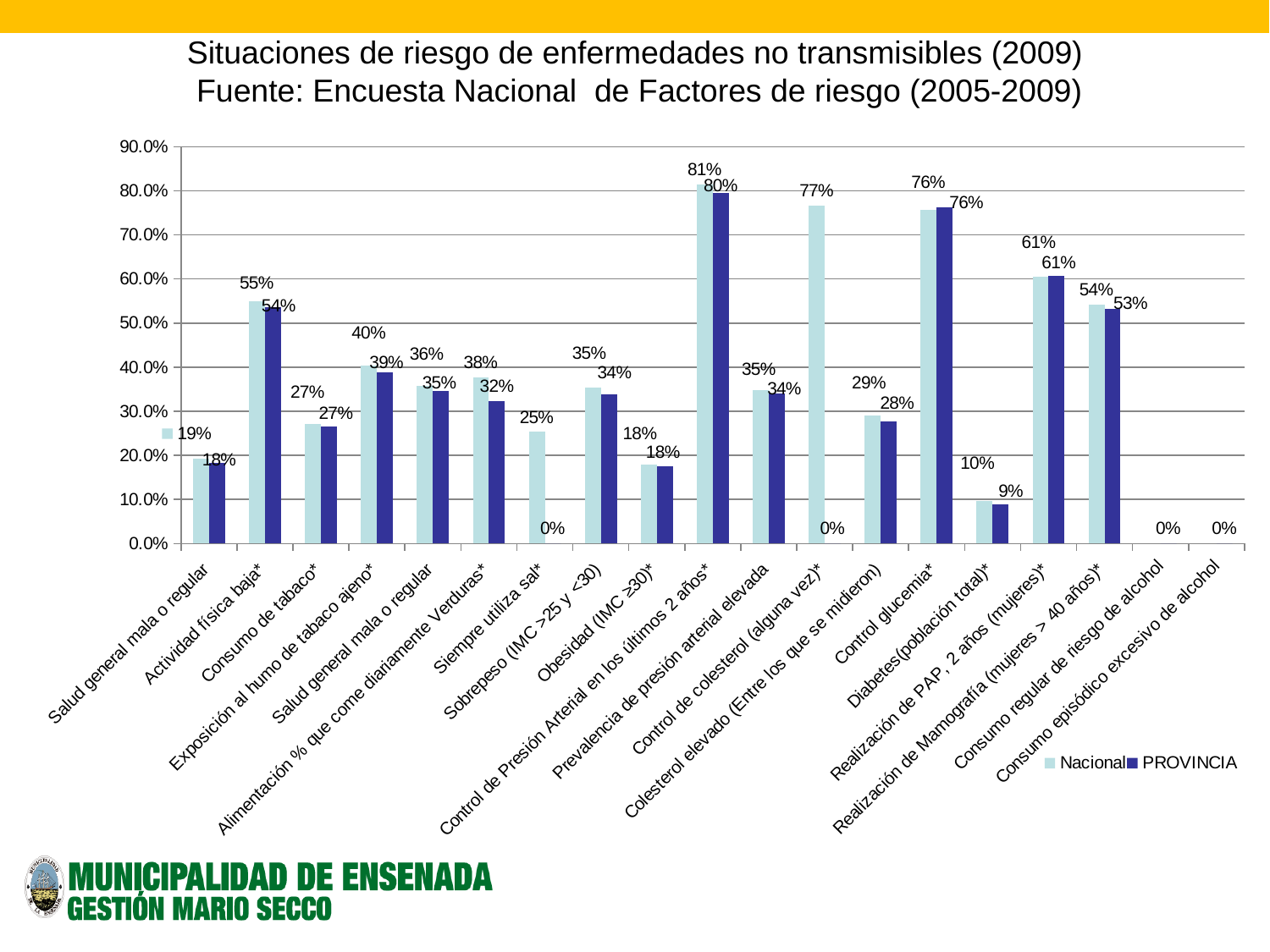
What is the difference between the Nacional and PROVINCIA values for Alimentación % que come diariamente Verduras*? 6 percentage points What is the Nacional value for Actividad física baja*? 55% What kind of chart is shown on the slide? Bar chart What is the PROVINCIA value for Siempre utiliza sal*? 0% How many series does the legend list? 2 How many categories are shown on the x axis? 19 Is the Nacional value for Control glucemia* greater or less than 70.0%? greater Which is larger for Realización de Mamografía (mujeres > 40 años)*: the Nacional value or the PROVINCIA value? Nacional What is the PROVINCIA value for Control glucemia*? 76% Which category has the highest Nacional value? Control de Presión Arterial en los últimos 2 años* What is the Nacional value for Control de colesterol (alguna vez)*? 77% Which category has the lowest PROVINCIA value among those with a non-zero bar? Diabetes(población total)*